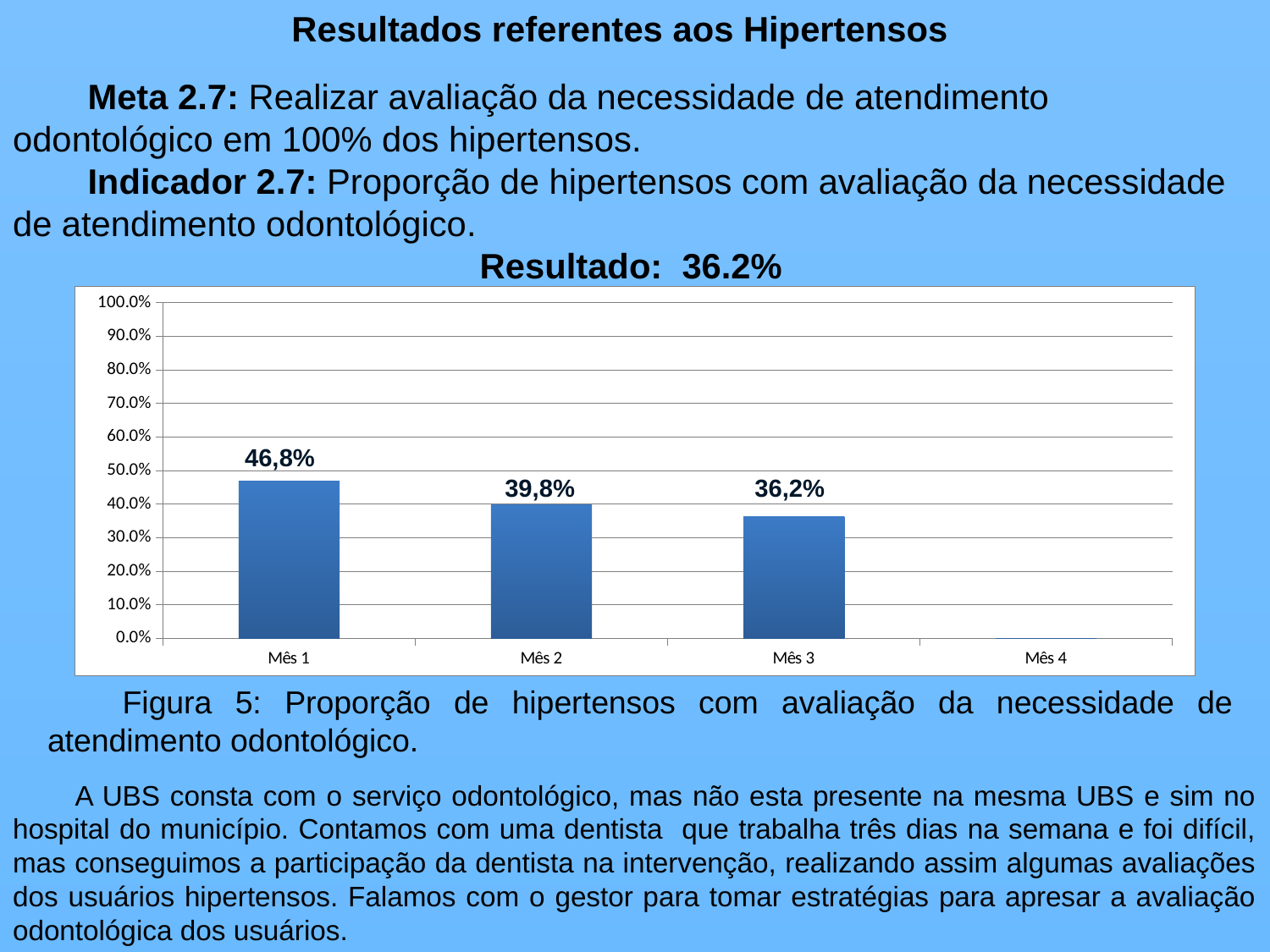
Which is larger, the value for Mês 2 or the value for Mês 3? Mês 2 Which month has the highest value? Mês 1 Among the months with a labeled bar, which has the lowest value? Mês 3 What is the value for Mês 1? 46,8% How many month categories are shown on the x axis? 4 Is the value for Mês 1 greater or less than 40.0%? greater What is the value for Mês 2? 39,8% What is the difference between the values for Mês 1 and Mês 2? 7,0% Do the values rise or fall from Mês 1 to Mês 3? fall What is the value for Mês 3? 36,2% What kind of chart is shown on the slide? bar chart What is the difference between the values for Mês 1 and Mês 3? 10,6%